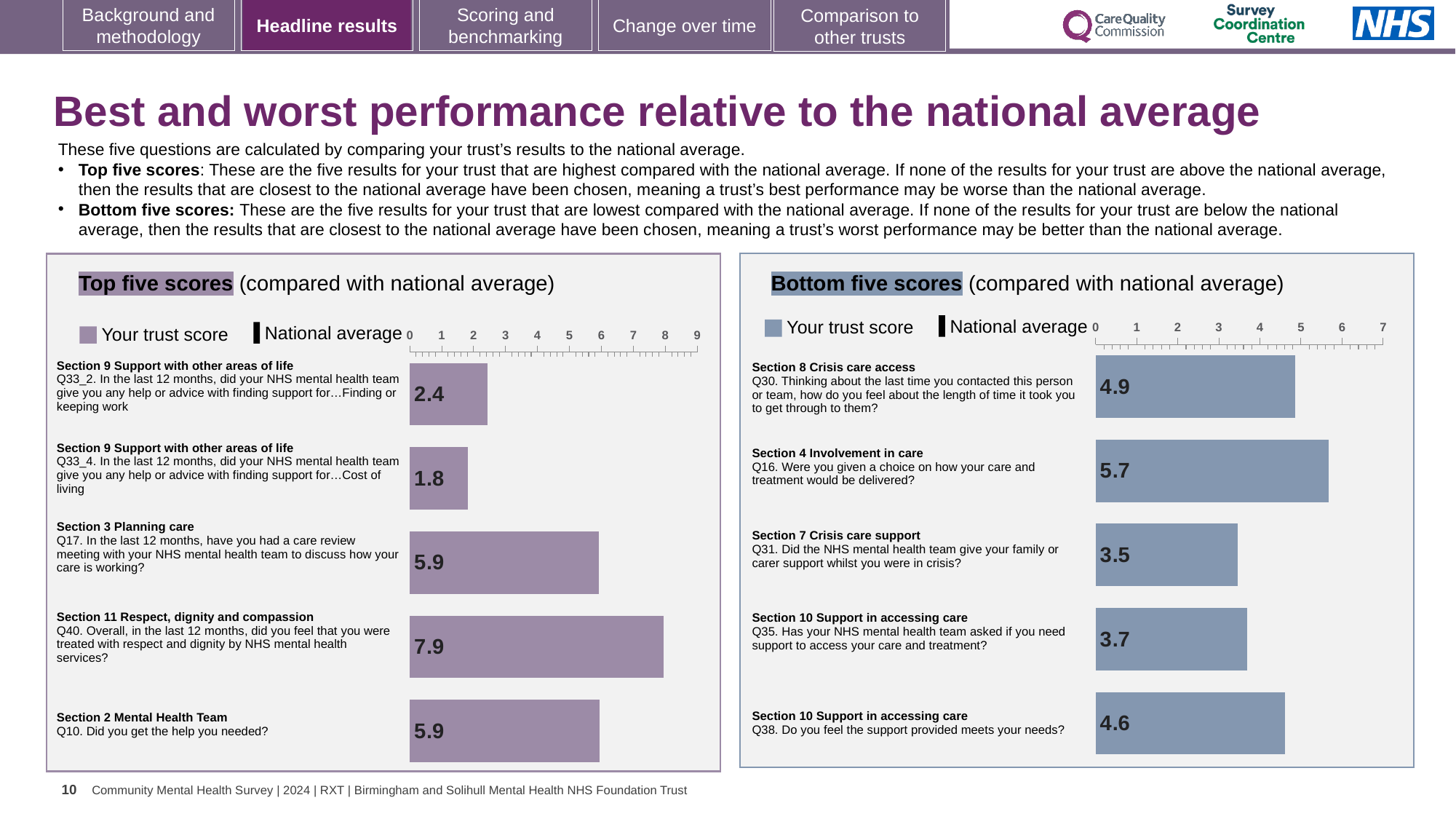
In the Top five scores chart, which question has the highest trust score? Q40 In the Bottom five scores chart, what is the difference between the trust scores for Q16 and Q35? 2.0 In the Bottom five scores chart, which has the larger trust score, Q30 or Q38? Q30 In the Bottom five scores chart, what is the trust score for Q31 (family or carer support whilst in crisis)? 3.5 In the Bottom five scores chart, which question has the lowest trust score? Q31 In the Top five scores chart, what is the trust score for Q33_4 (support with cost of living)? 1.8 In the Top five scores chart, what is the difference between the trust scores for Q40 and Q33_2? 5.5 How many series does the legend of the Top five scores chart list? 2 In the Top five scores chart, what is the trust score for Q40 (treated with respect and dignity)? 7.9 What type of chart is the Top five scores chart? Bar chart In the Bottom five scores chart, what is the trust score for Q16 (choice on how care and treatment would be delivered)? 5.7 How many questions are shown in the Bottom five scores chart? 5